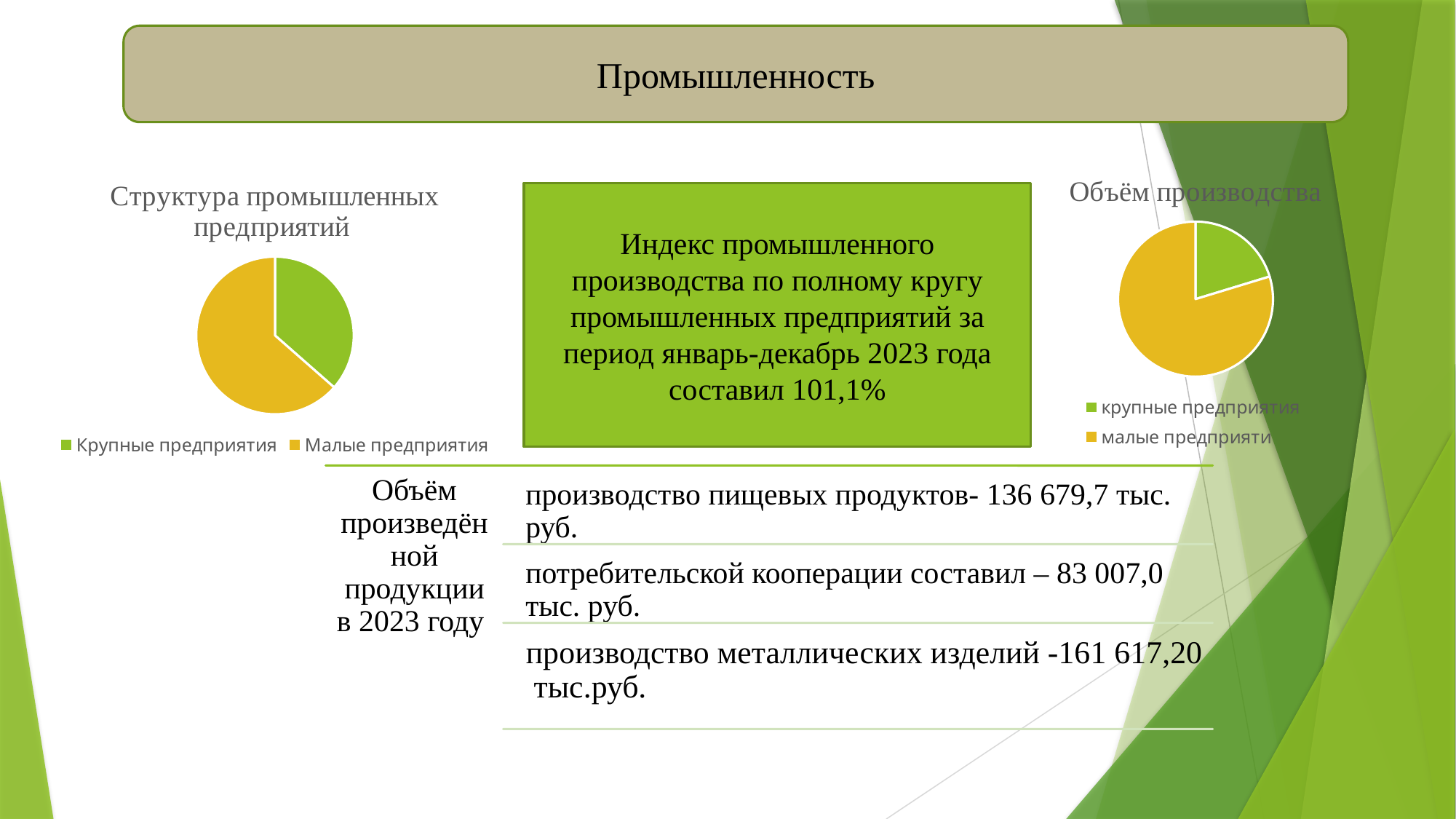
In the chart titled "Структура промышленных предприятий", is the slice for Крупные предприятия larger or smaller than the slice for Малые предприятия? smaller In the chart titled "Объём производства", is the slice for малые предприятия larger or smaller than the slice for крупные предприятия? larger In the chart titled "Структура промышленных предприятий", what colour is the slice for Малые предприятия? yellow In the chart titled "Объём производства", how many slices does the pie have? 2 What is the title of the pie chart on the right side of the slide? Объём производства In the chart titled "Структура промышленных предприятий", how many categories does the legend list? 2 What kind of chart is the chart titled "Объём производства"? pie chart What kind of chart is the chart titled "Структура промышленных предприятий"? pie chart In the chart titled "Объём производства", which category has the largest slice? малые предприятия In the chart titled "Структура промышленных предприятий", which category has the smallest slice? Крупные предприятия In the chart titled "Объём производства", which category has the smallest slice? крупные предприятия In the chart titled "Структура промышленных предприятий", which category has the largest slice? Малые предприятия